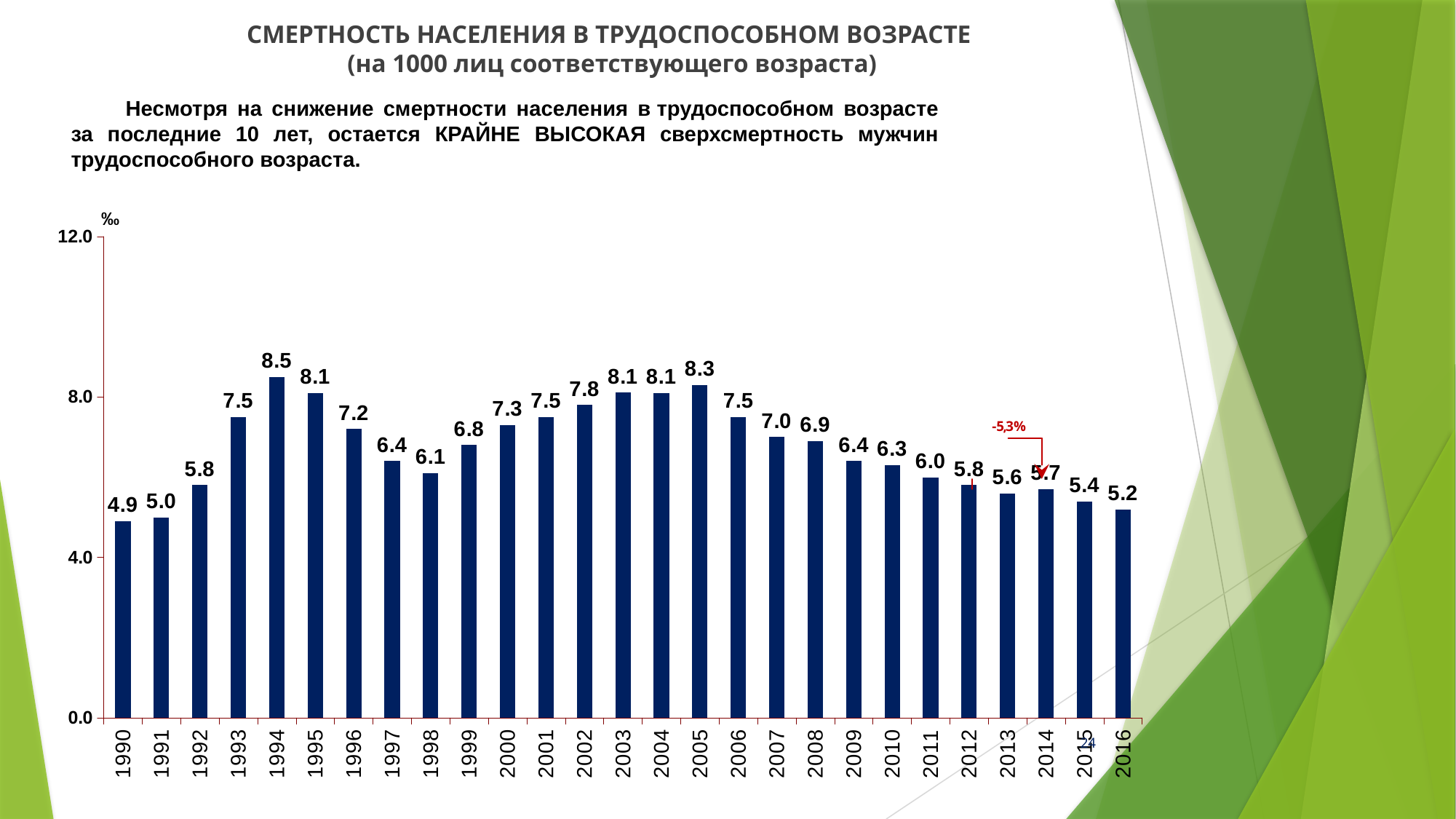
Which year has the highest value? 1994 Is the value for 2003 greater or less than 8.0? greater What is the value for 2016? 5.2 What is the value for 1994? 8.5 Which is larger, the value for 1996 or the value for 2000? 2000 Do the values rise or fall from 2005 to 2016? fall How many years are shown on the x axis? 27 What kind of chart is shown on the slide? bar chart Which year has the lowest value? 1990 What is the difference between the values for 1994 and 2016? 3.3 What is the value for 2005? 8.3 What is the difference between the values for 2005 and 2006? 0.8